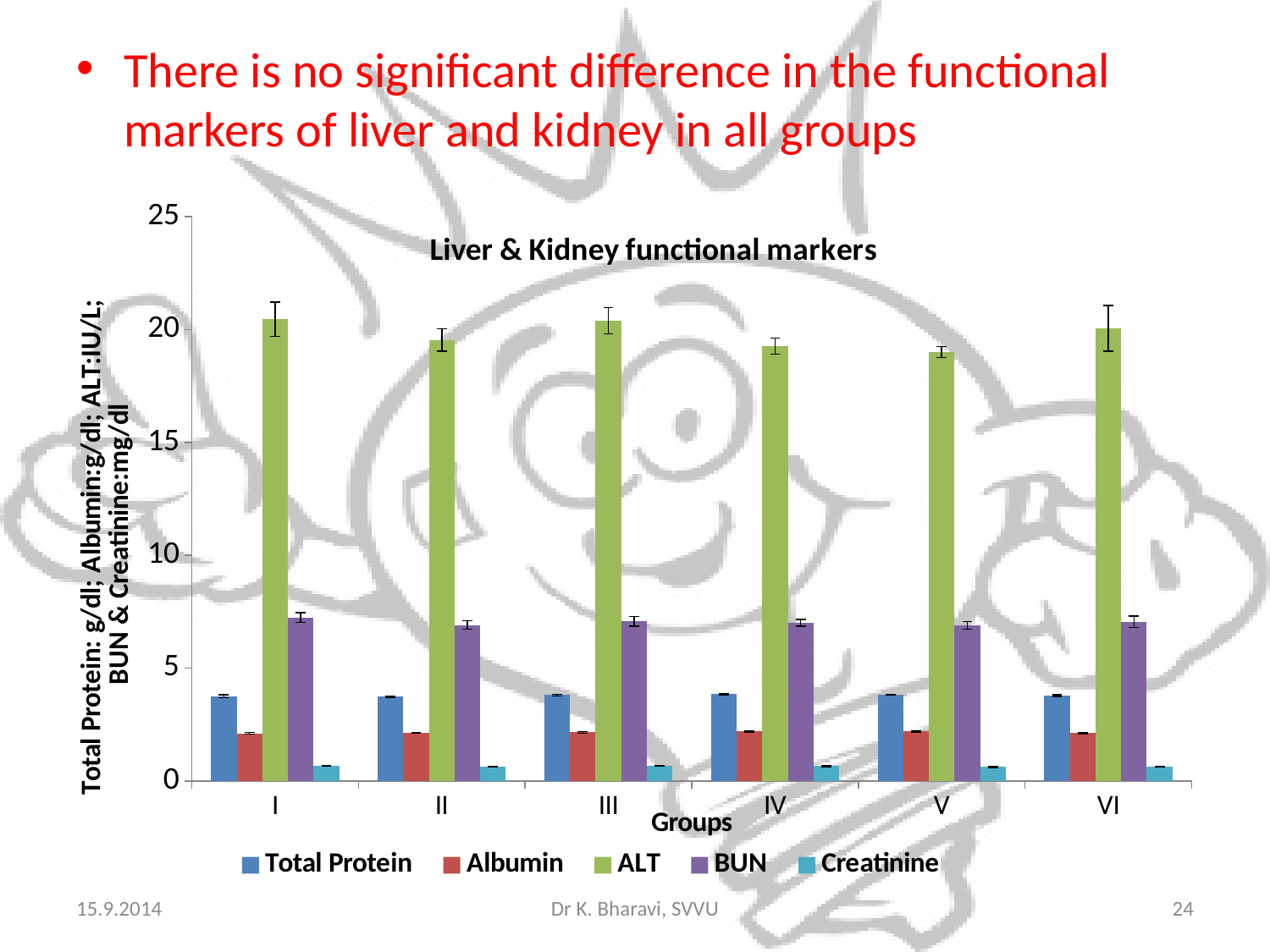
Is the ALT value for group I greater or less than 20? greater Is the ALT value for group V greater or less than 20? less What kind of chart is shown on the slide? bar chart Is the BUN value for group II greater or less than 5? greater Which series has the lowest value in group III? Creatinine How many series does the legend list? 5 How many groups are shown on the x axis? 6 What is the label of the x axis? Groups In group VI, which is larger, the ALT value or the BUN value? ALT What is the title of the chart? Liver & Kidney functional markers Which series has the highest value in group I? ALT